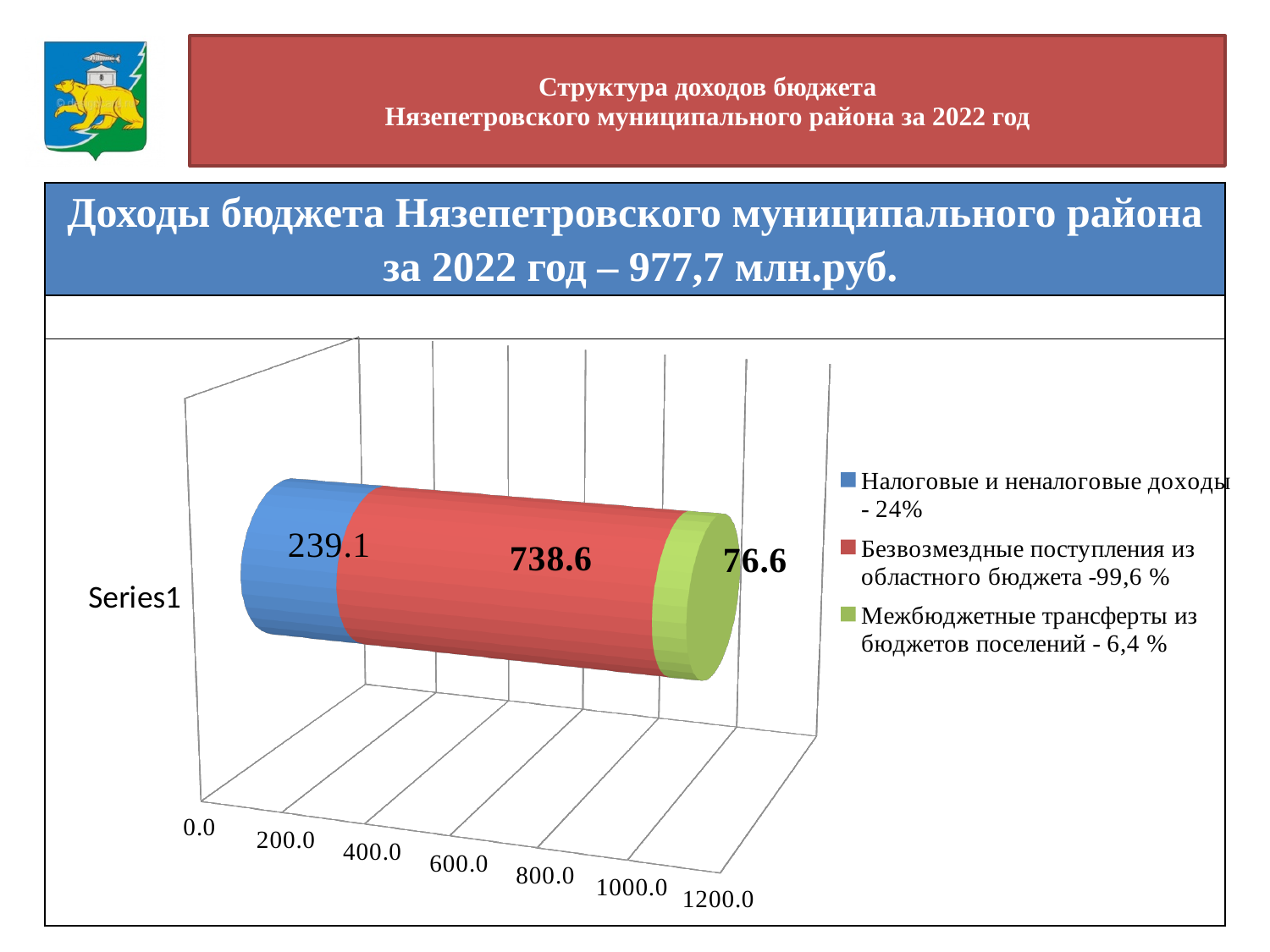
What is the value for Налоговые и неналоговые доходы? 239.1 Which is larger: the value for Налоговые и неналоговые доходы or the value for Межбюджетные трансферты из бюджетов поселений? Налоговые и неналоговые доходы What is the value for Межбюджетные трансферты из бюджетов поселений? 76.6 What is the difference between the values for Безвозмездные поступления из областного бюджета and Налоговые и неналоговые доходы? 499.5 Which series has the lowest value? Межбюджетные трансферты из бюджетов поселений What colour represents Безвозмездные поступления из областного бюджета in the chart? red What is the value for Безвозмездные поступления из областного бюджета? 738.6 How many series does the legend list? 3 What kind of chart is shown on the slide? bar chart What is the total of the stacked bar for Series1? 1054.3 What is the difference between the values for Налоговые и неналоговые доходы and Межбюджетные трансферты из бюджетов поселений? 162.5 Which series has the highest value? Безвозмездные поступления из областного бюджета